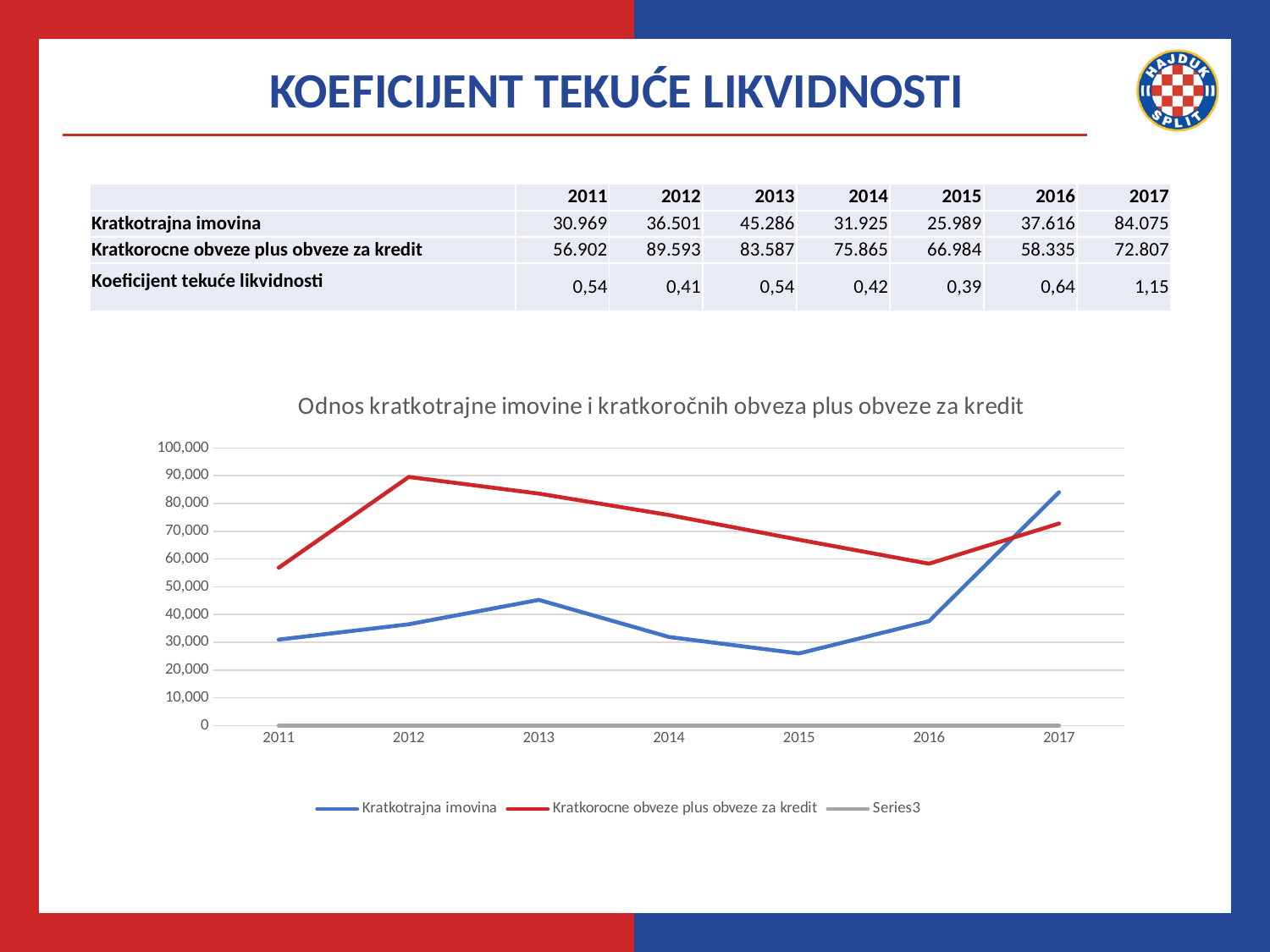
Is the value for Kratkotrajna imovina in 2015 greater or less than 30,000? less What kind of chart is shown on the slide? line chart How many series does the chart legend list? 3 Does the Kratkorocne obveze plus obveze za kredit line rise or fall between 2012 and 2016? fall In which year does the Kratkorocne obveze plus obveze za kredit line reach its lowest value? 2016 In which year does the Kratkorocne obveze plus obveze za kredit line reach its highest value? 2012 In 2017, which series has the higher value: Kratkotrajna imovina or Kratkorocne obveze plus obveze za kredit? Kratkotrajna imovina How many years are plotted along the x axis of the chart? 7 What is the title of the chart? Odnos kratkotrajne imovine i kratkoročnih obveza plus obveze za kredit Is the value for Kratkotrajna imovina in 2017 greater or less than 80,000? greater In which year does the Kratkotrajna imovina line reach its lowest value? 2015 In which year does the Kratkotrajna imovina line reach its highest value? 2017